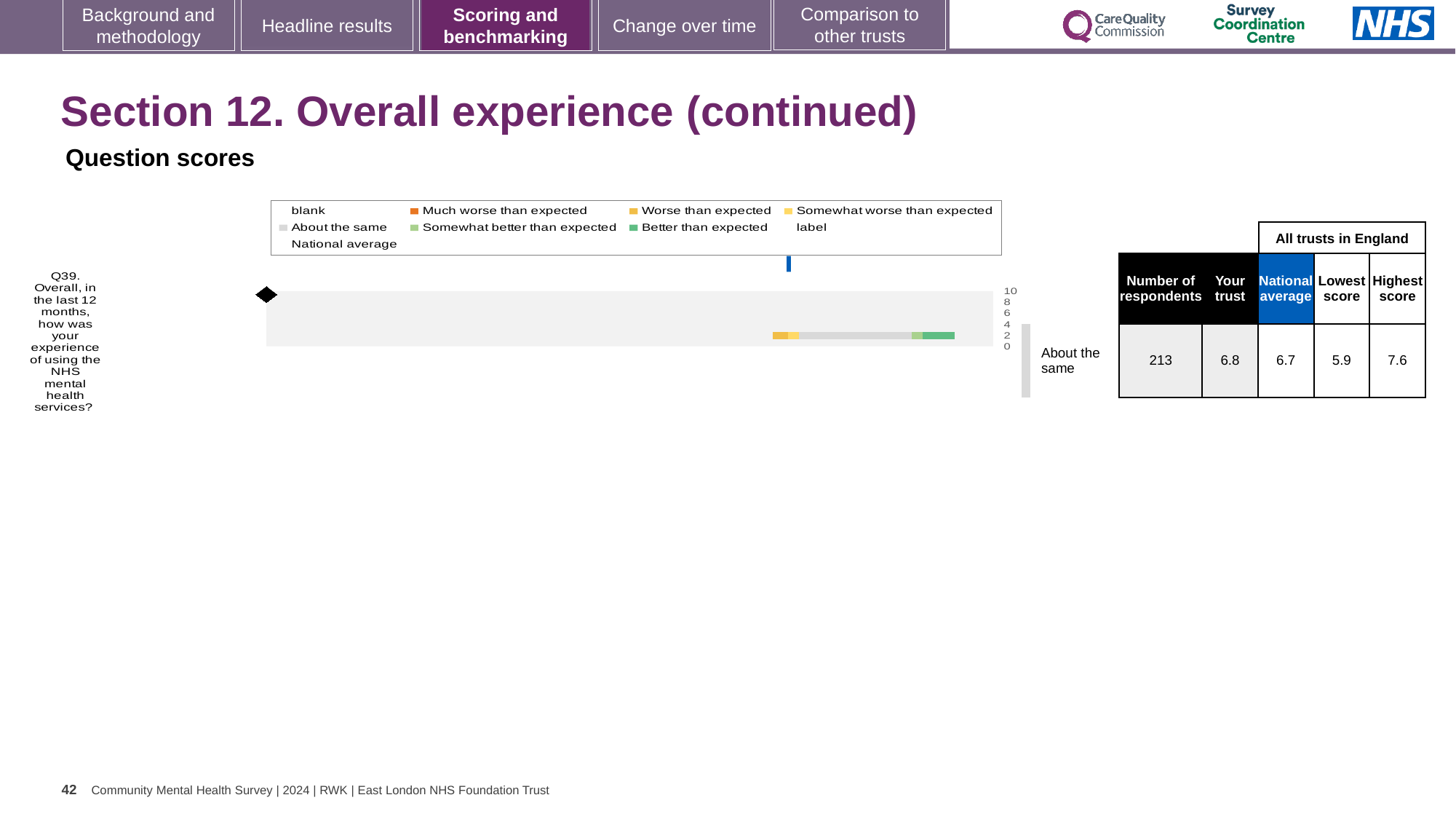
In the legend, what colour represents 'Better than expected'? green In the table next to the chart, what is the difference between the highest score and the lowest score for Q39? 1.7 In the table next to the chart, what is the lowest score among all trusts in England for Q39? 5.9 What benchmark category is shown to the right of the bar for Q39? About the same In the table next to the chart, how many respondents answered Q39? 213 In the table next to the chart, what is the highest score among all trusts in England for Q39? 7.6 How many survey questions are plotted in the chart on this slide? 1 Which question is plotted in the chart on this slide? Q39. Overall, in the last 12 months, how was your experience of using the NHS mental health services? What kind of chart is shown on the slide for Q39? bar chart In the table next to the chart, what is the national average score for Q39? 6.7 In the table next to the chart, what is the 'Your trust' score for Q39? 6.8 In the table next to the chart, which is higher for Q39: the 'Your trust' score or the national average? Your trust